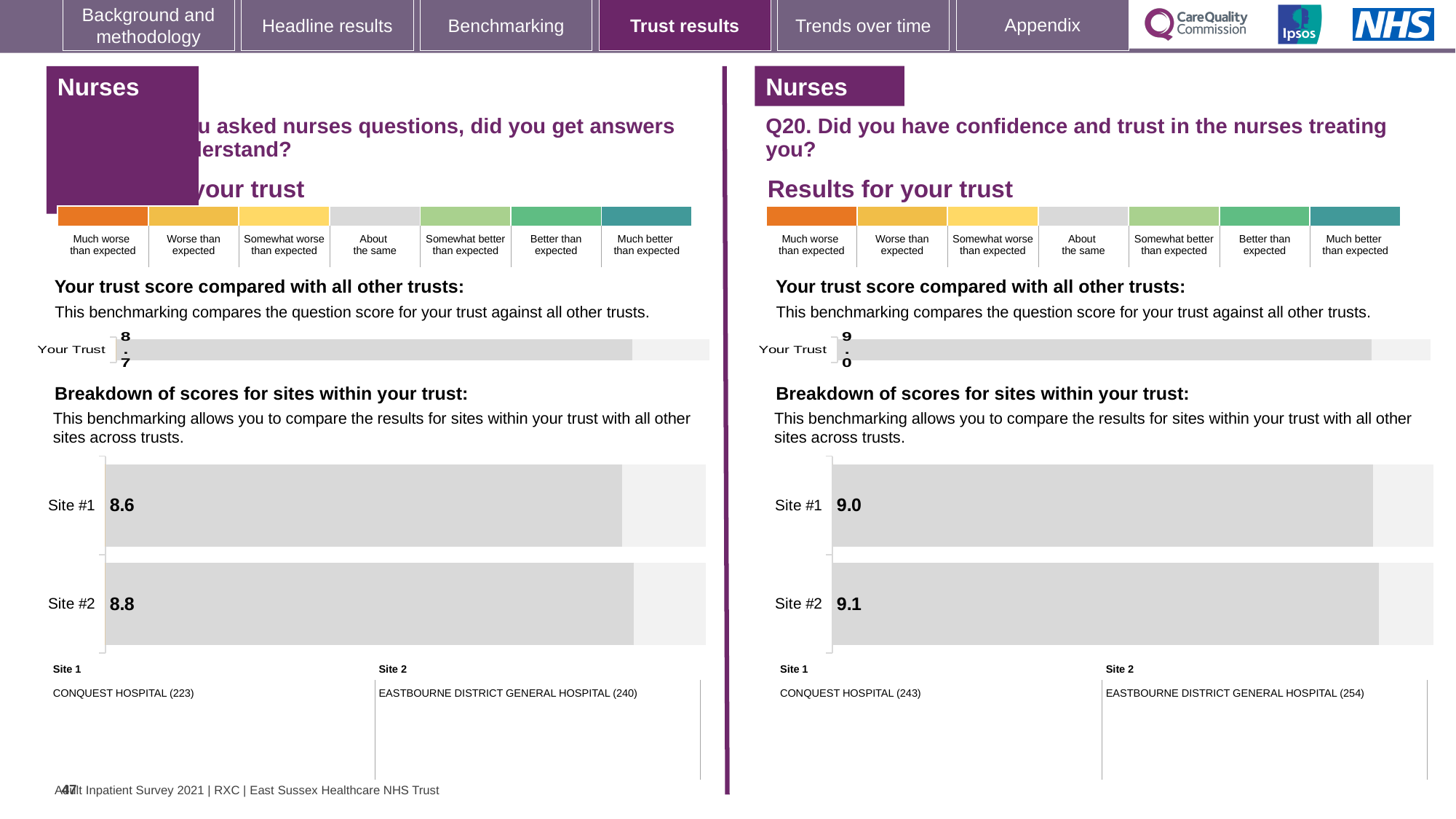
On the left-hand sites breakdown chart, what is the difference between the Site #2 and Site #1 scores? 0.2 On the right-hand sites breakdown chart (Q20), what is the difference between the Site #2 and Site #1 scores? 0.1 On the left-hand chart, what is the score shown for Your Trust? 8.7 On the left-hand sites breakdown chart, which site has the higher score? Site #2 How many sites are shown in the sites breakdown chart on the right-hand side (Q20)? 2 What type of chart is used for the breakdown of scores for sites on the right-hand side (Q20)? Bar chart On the right-hand chart (Q20, confidence and trust in nurses), what is the score for Site #1? 9.0 On the right-hand chart (Q20), what is the score shown for Your Trust? 9.0 On the right-hand chart (Q20, confidence and trust in nurses), what is the score for Site #2? 9.1 On the left-hand chart (nurses question, sites breakdown), what is the score for Site #1? 8.6 On the left-hand chart (nurses question, sites breakdown), what is the score for Site #2? 8.8 On the right-hand sites breakdown chart (Q20), which site has the lower score? Site #1